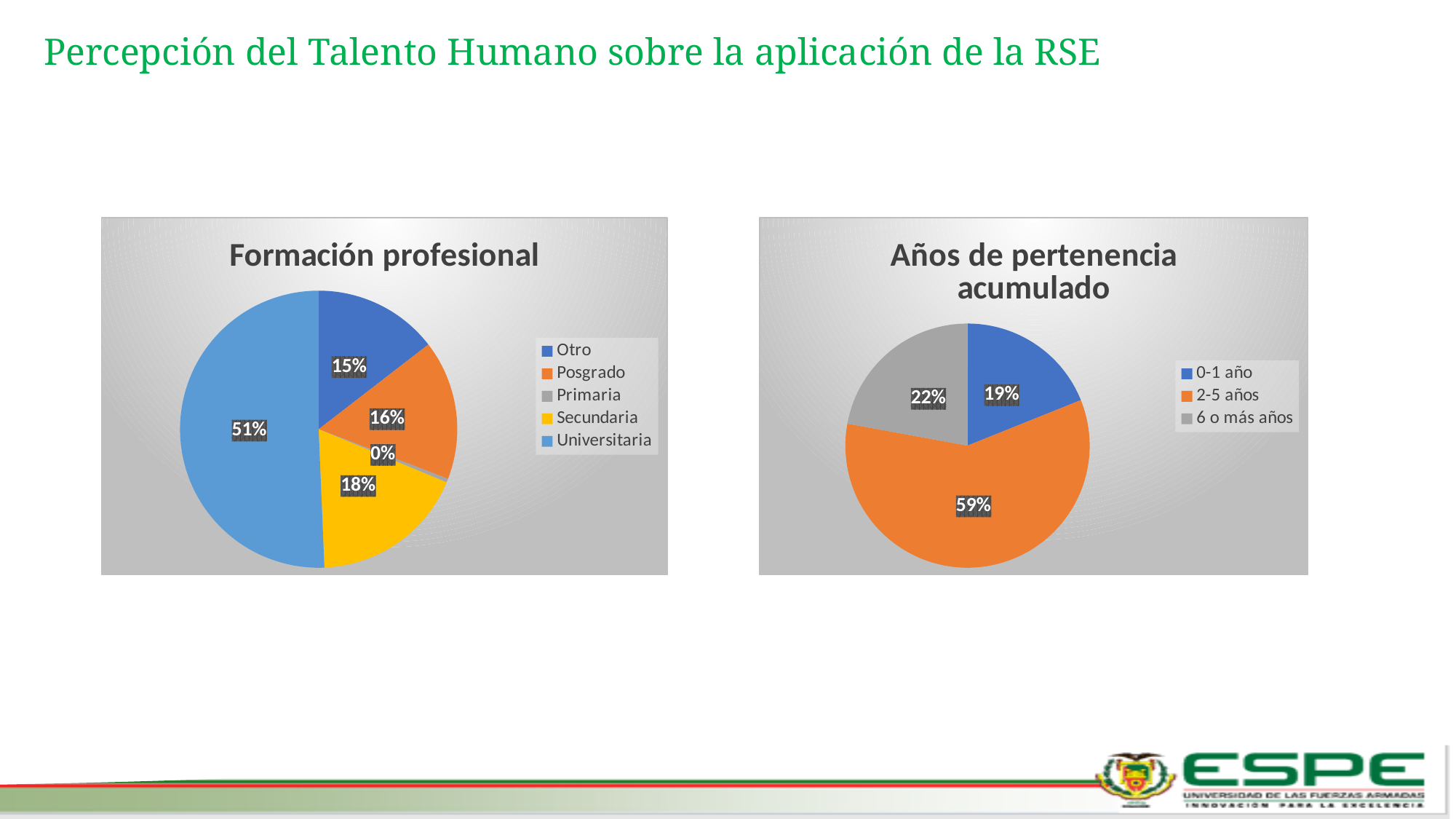
In the 'Años de pertenencia acumulado' chart, what share does '2-5 años' have? 59% In the 'Formación profesional' chart, what is the difference between the Universitaria and Posgrado shares? 35% In the 'Formación profesional' chart, which category has the smallest share? Primaria In the 'Años de pertenencia acumulado' chart, what share does '0-1 año' have? 19% In the 'Años de pertenencia acumulado' chart, which category has the largest share? 2-5 años What kind of chart is 'Formación profesional'? Pie chart In the 'Formación profesional' chart, what share does Secundaria have? 18% In the 'Años de pertenencia acumulado' chart, what colour is the '2-5 años' slice? Orange In the 'Formación profesional' chart, what share does Universitaria have? 51% In the 'Formación profesional' chart, which category has the largest share? Universitaria In the 'Formación profesional' chart, how many categories does the legend list? 5 In the 'Años de pertenencia acumulado' chart, which is larger: '6 o más años' or '0-1 año'? 6 o más años